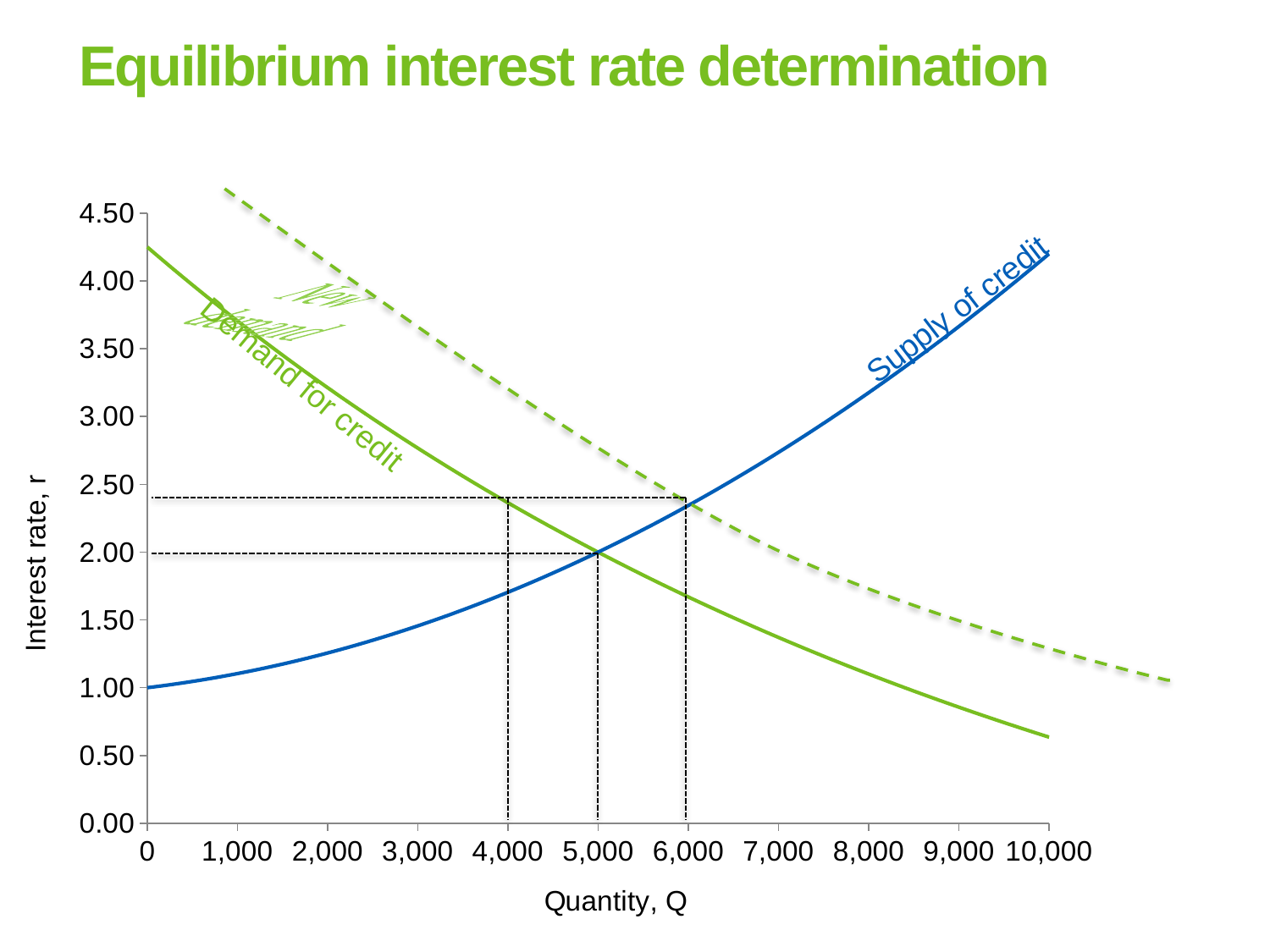
What is the label of the x axis? Quantity, Q What kind of chart is shown on the slide? line chart Does the Demand for credit curve rise or fall as quantity increases? falls Is the interest rate on the Supply of credit curve at a quantity of 10,000 greater or less than 4.00? greater What is the title of the slide's chart? Equilibrium interest rate determination Is the interest rate on the Demand for credit curve at a quantity of 10,000 greater or less than 1.00? less Does the Supply of credit curve rise or fall as quantity increases? rises At a quantity of 2,000, which curve shows the higher interest rate, Demand for credit or Supply of credit? Demand for credit What is the interest rate on the Supply of credit curve at a quantity of 0? 1.00 What is the interest rate at the intersection of the Demand for credit and Supply of credit curves? 2.00 Is the interest rate on the Demand for credit curve at a quantity of 0 greater or less than 4.00? greater At what quantity do the Demand for credit and Supply of credit curves intersect? 5,000